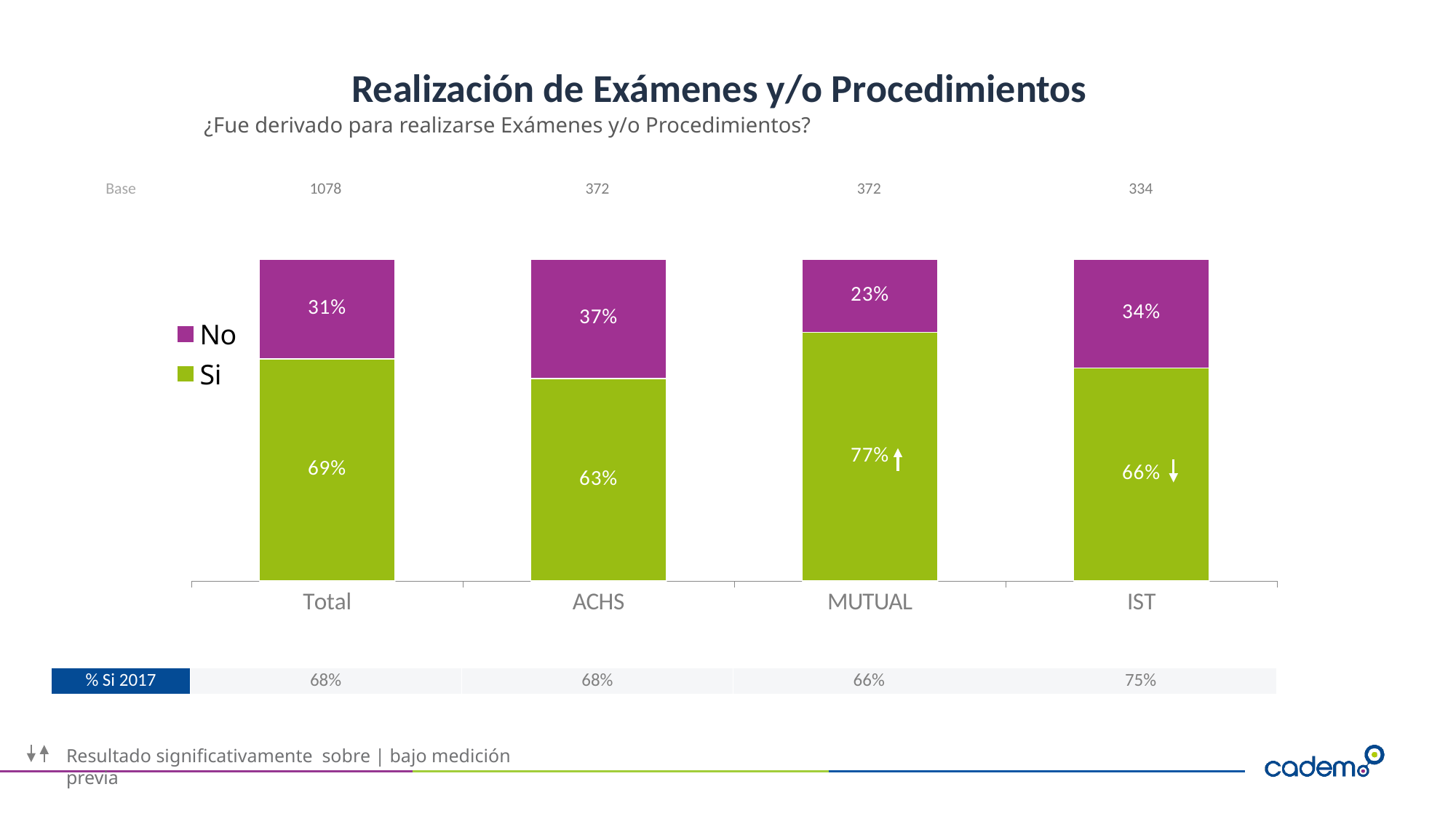
What is the 'Si' value for MUTUAL? 77% Which is larger, the 'Si' value for Total or the 'Si' value for IST? Total What is the 'No' value for ACHS? 37% What is the 'Si' value for Total? 69% Which category has the highest 'Si' value? MUTUAL How many categories are shown on the x axis? 4 What is the 'No' value for IST? 34% What is the total of the stacked bar for ACHS? 100% What is the difference between the 'No' values for ACHS and MUTUAL? 14% What kind of chart is shown on the slide? Stacked bar chart How many series does the legend list? 2 Which category has the lowest 'Si' value? ACHS